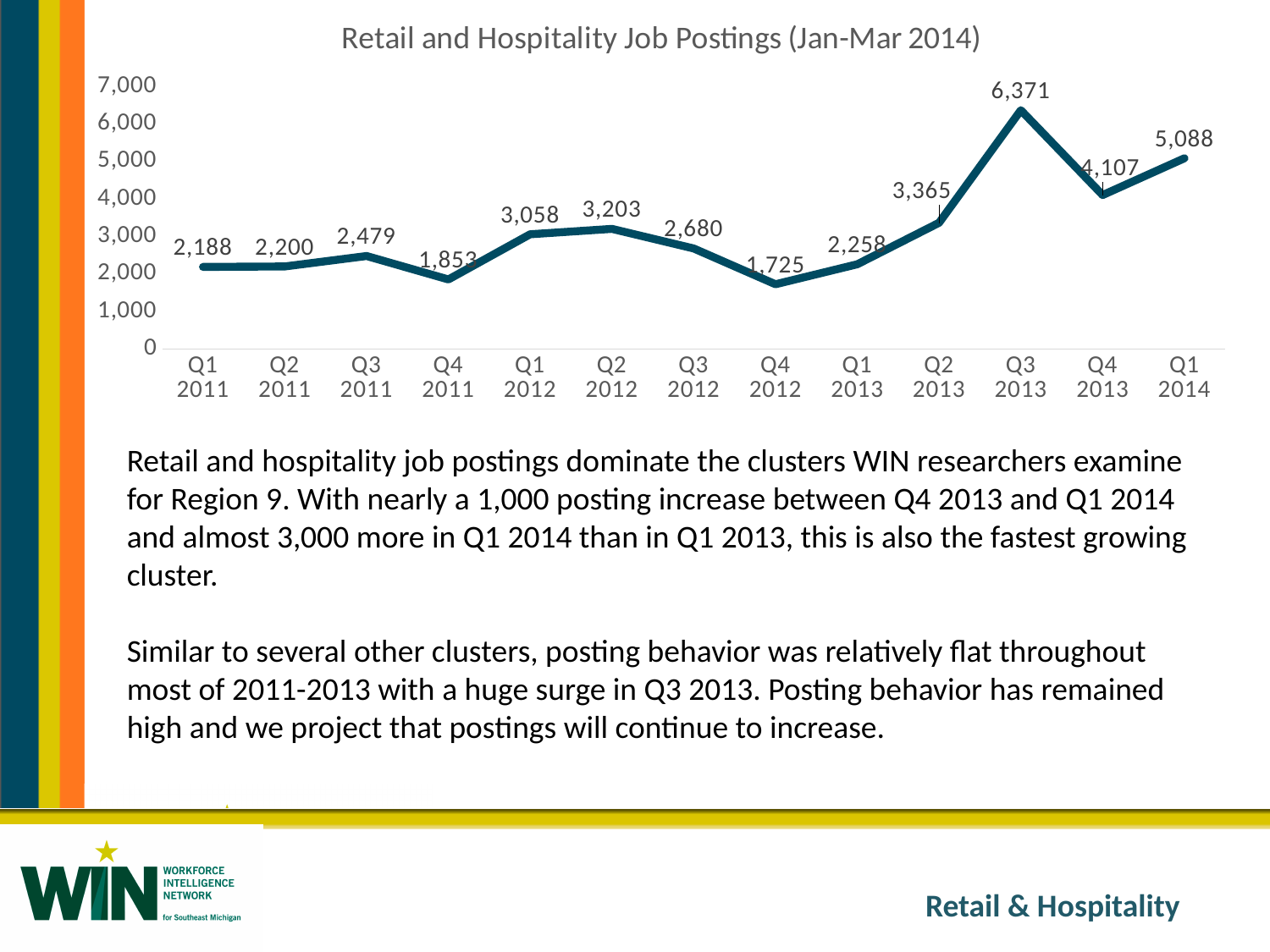
What is the title of the chart? Retail and Hospitality Job Postings (Jan-Mar 2014) Is the value for Q3 2013 greater or less than 6,000? greater How many quarters are plotted on the chart? 13 What is the difference between the values for Q1 2014 and Q4 2013? 981 What is the value for Q1 2014? 5,088 Which quarter has the highest number of job postings? Q3 2013 What is the difference between the values for Q3 2013 and Q2 2013? 3,006 What is the value for Q3 2013? 6,371 Which quarter has the lowest number of job postings? Q4 2012 What kind of chart is shown on the slide? line chart Which is larger, the value for Q2 2012 or the value for Q3 2012? Q2 2012 What is the value for Q4 2011? 1,853